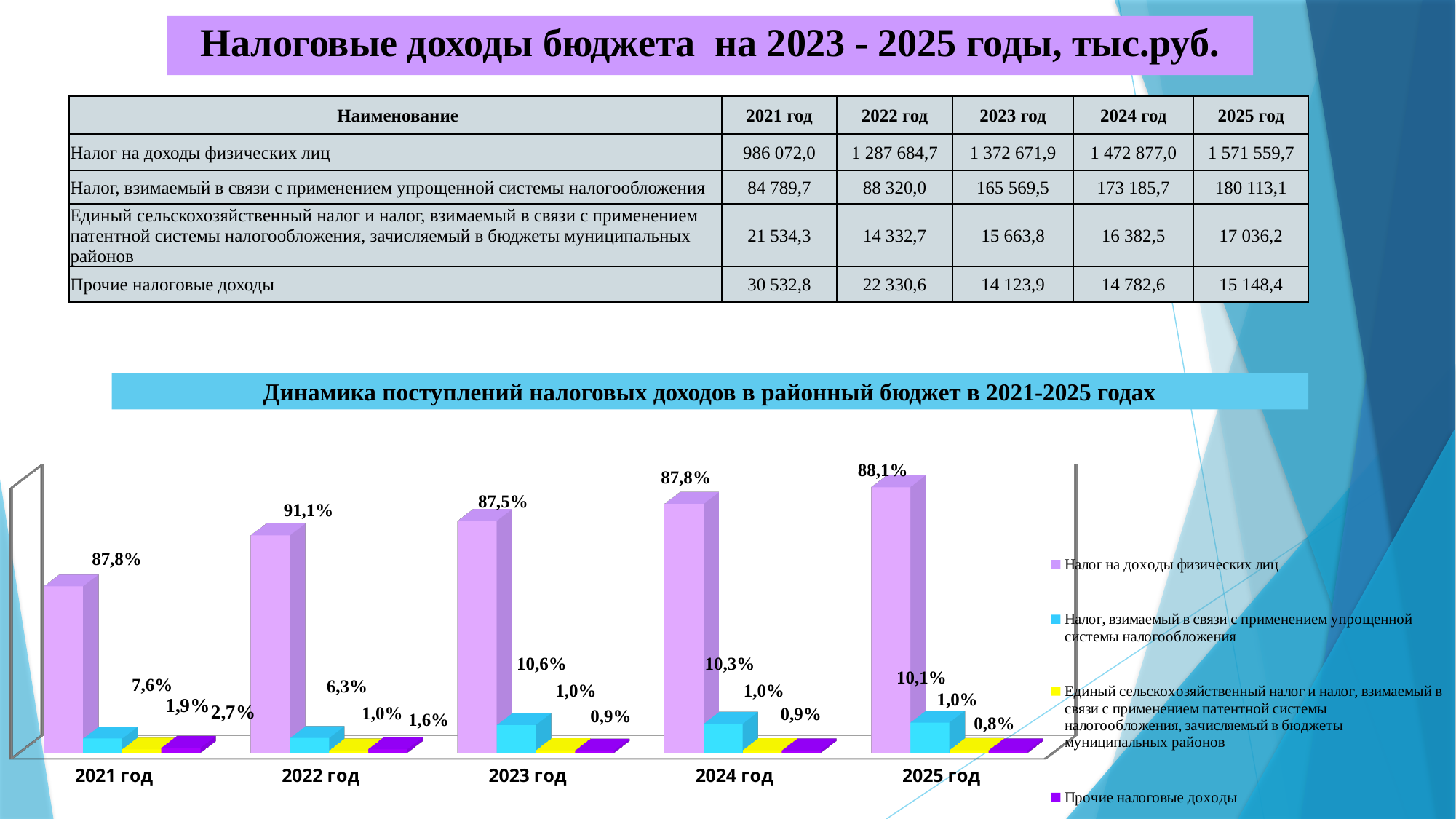
In the chart, what is the difference between the "Налог на доходы физических лиц" values for 2022 год and 2023 год? 3,6% In the chart, what is the value for "Налог, взимаемый в связи с применением упрощенной системы налогообложения" in 2023 год? 10,6% In the chart, what is the value for "Налог на доходы физических лиц" in 2022 год? 91,1% What kind of chart is shown under the heading "Динамика поступлений налоговых доходов в районный бюджет в 2021-2025 годах"? bar chart In the chart, which series is shown in yellow? Единый сельскохозяйственный налог и налог, взимаемый в связи с применением патентной системы налогообложения, зачисляемый в бюджеты муниципальных районов How many year categories are shown on the x axis of the chart? 5 In the chart, what is the value for "Налог на доходы физических лиц" in 2025 год? 88,1% In the chart, which is larger: the "Прочие налоговые доходы" value for 2021 год or for 2025 год? 2021 год In the chart, what is the value for "Прочие налоговые доходы" in 2021 год? 2,7% How many series does the legend of the chart list? 4